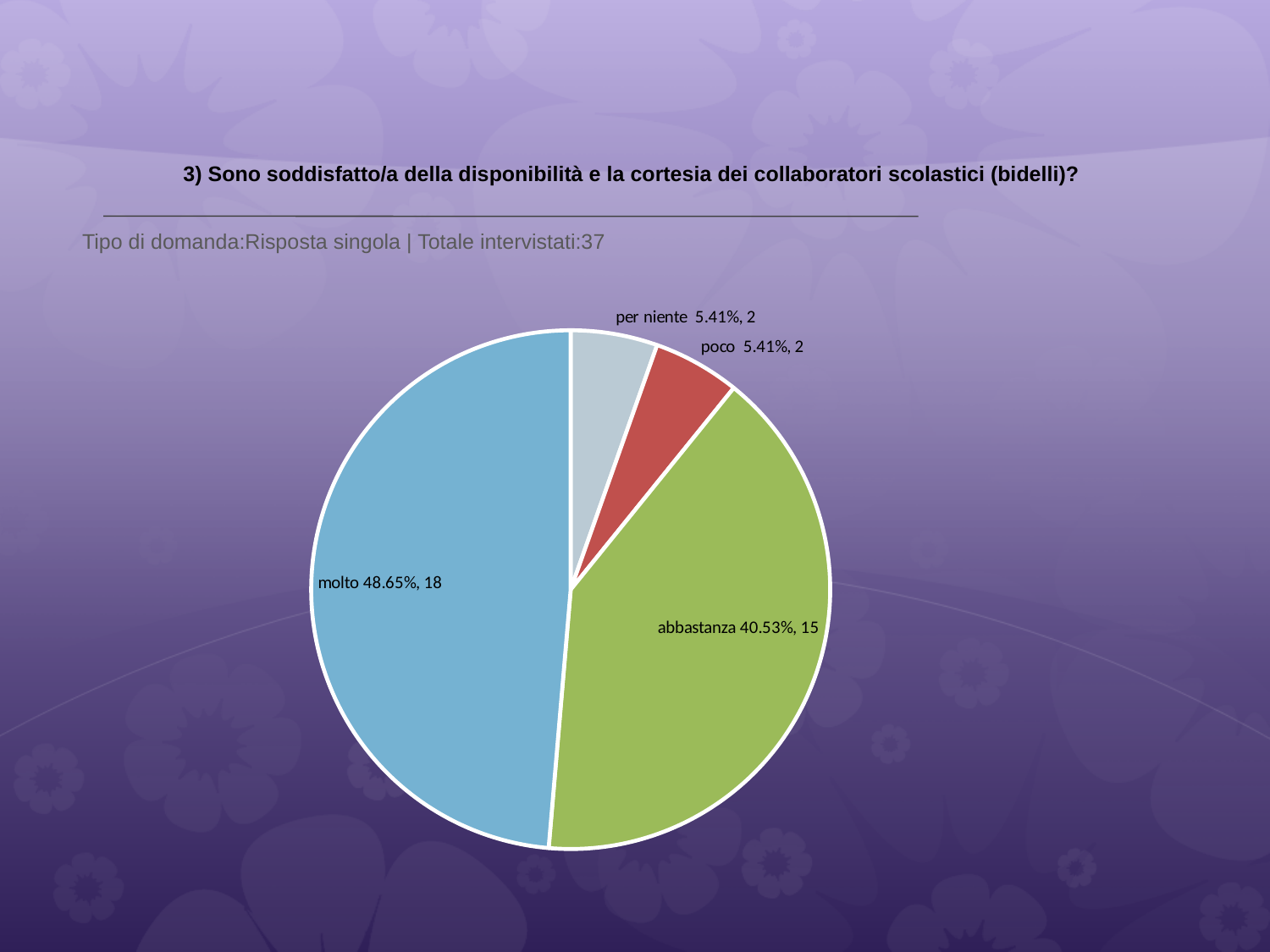
How many respondents answered "per niente"? 2 How many slices does the pie chart have? 4 What percentage of respondents answered "molto"? 48.65% What is the difference in number of respondents between "molto" and "abbastanza"? 3 What kind of chart is shown on the slide? pie chart What is the difference in percentage points between "abbastanza" and "poco"? 35.12 What colour is the "abbastanza" slice of the pie chart? green What percentage of respondents answered "poco"? 5.41% What is the total number of respondents (Totale intervistati) stated on the slide? 37 How many respondents answered "abbastanza"? 15 Which response has the largest share of the pie? molto Which is larger, the share for "molto" or the share for "abbastanza"? molto